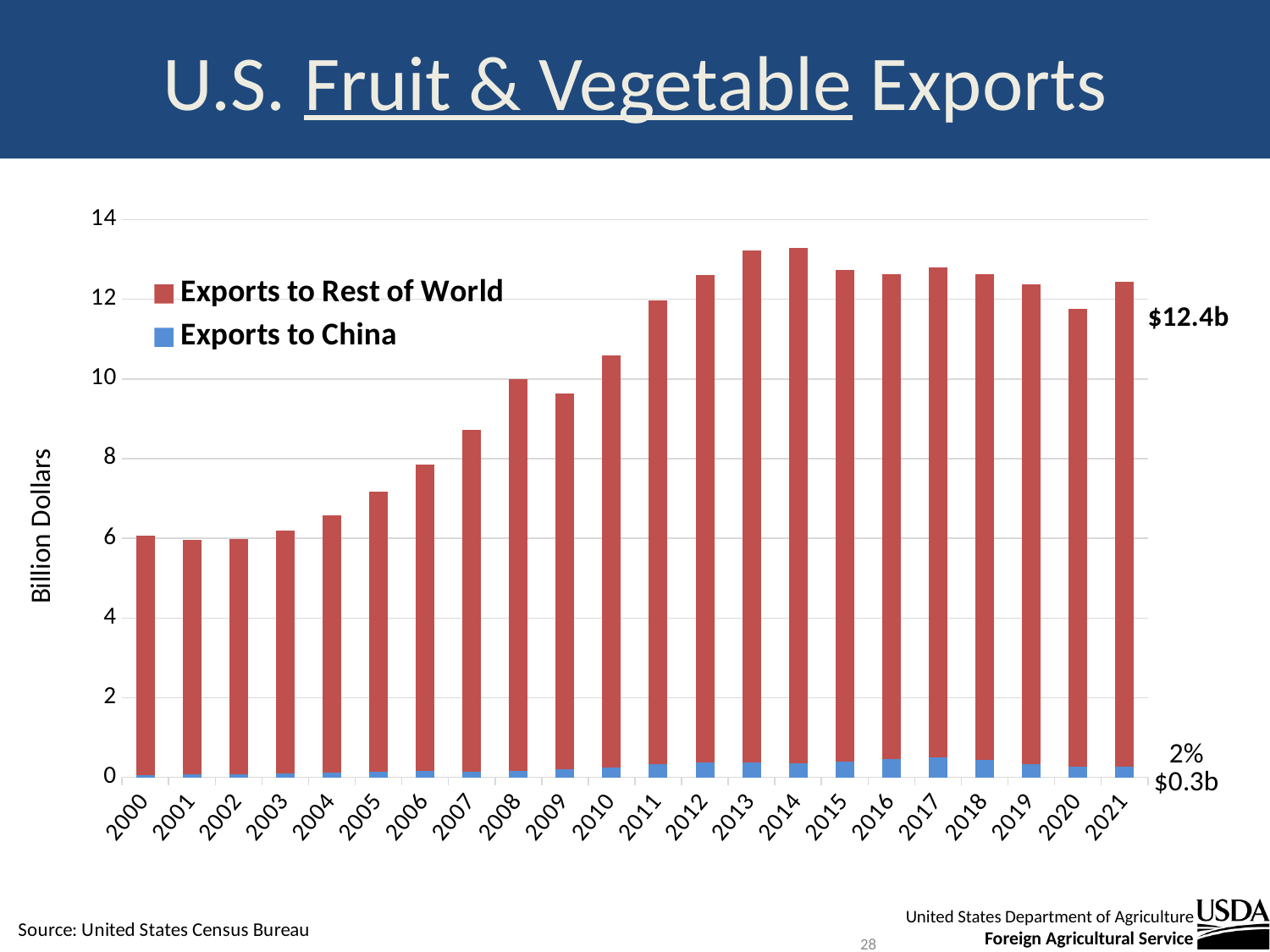
What is the label on the y axis? Billion Dollars What kind of chart is shown on the slide? Bar chart Is the total value for 2000 greater or less than 8? less What share of 2021 exports went to China, according to the label on the chart? 2% Do total exports generally rise or fall from 2000 to 2013? Rise Is the total value for 2014 greater or less than 12? greater What total value is labelled for the 2021 bar? $12.4b Which year has the larger total bar, 2005 or 2010? 2010 How many years are shown along the x axis? 22 What is the value of Exports to China in 2021? $0.3b How many series does the legend list? 2 What colour represents Exports to China in the chart? Blue